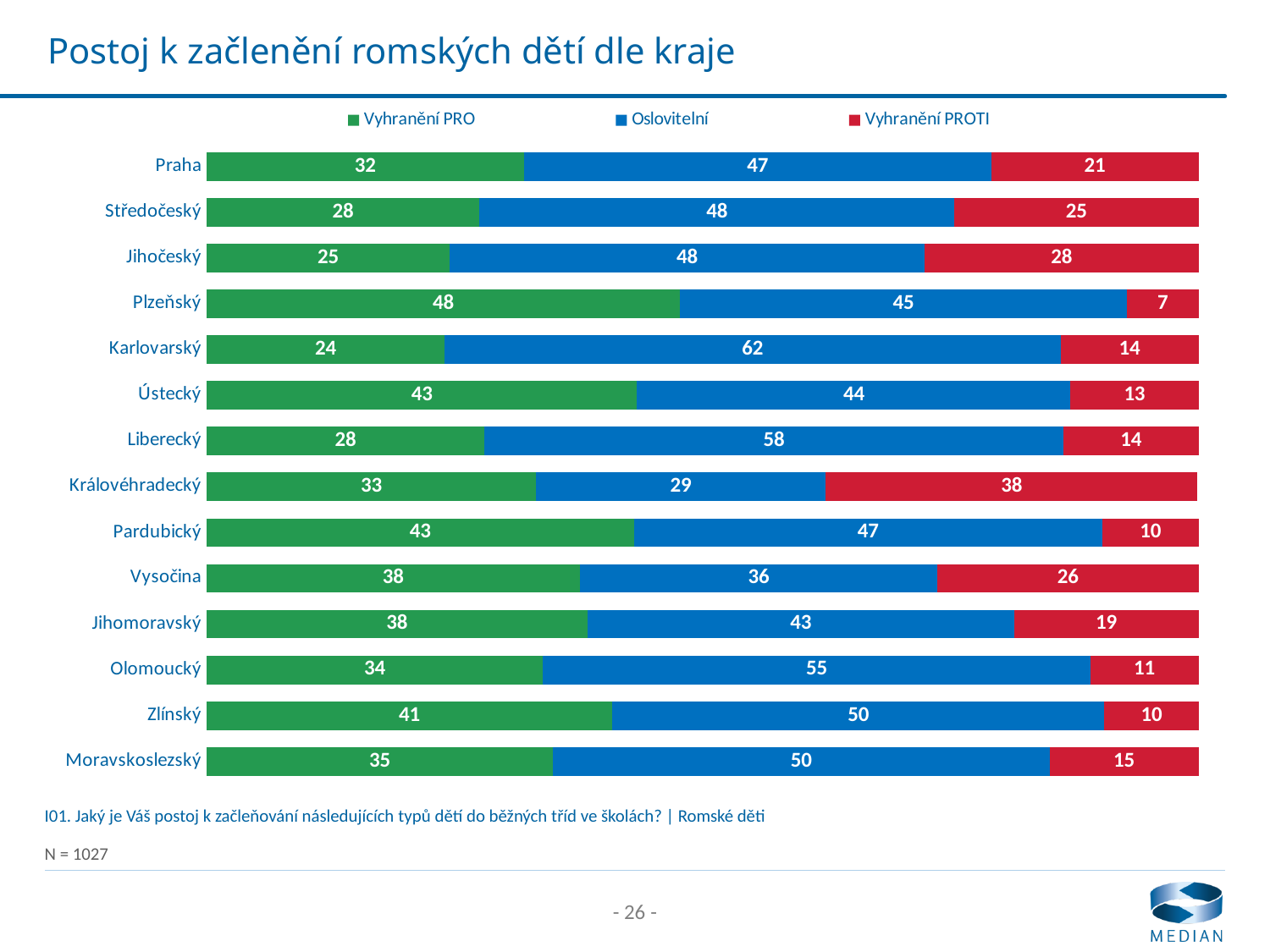
Which region has the lowest value for Vyhranění PROTI? Plzeňský What is the value of Vyhranění PRO for Praha? 32 Which region has the highest value for Oslovitelní? Karlovarský How many regions are shown in the chart? 14 How many series does the legend list? 3 What is the difference between the Oslovitelní and Vyhranění PRO values for Praha? 15 What is the value of Vyhranění PROTI for Královéhradecký? 38 What kind of chart is shown on the slide? Stacked bar chart Which is larger: the Vyhranění PRO value for Ústecký or for Vysočina? Ústecký Which region has the highest value for Vyhranění PRO? Plzeňský What is the total of the three values for Plzeňský? 100 What is the value of Oslovitelní for Karlovarský? 62